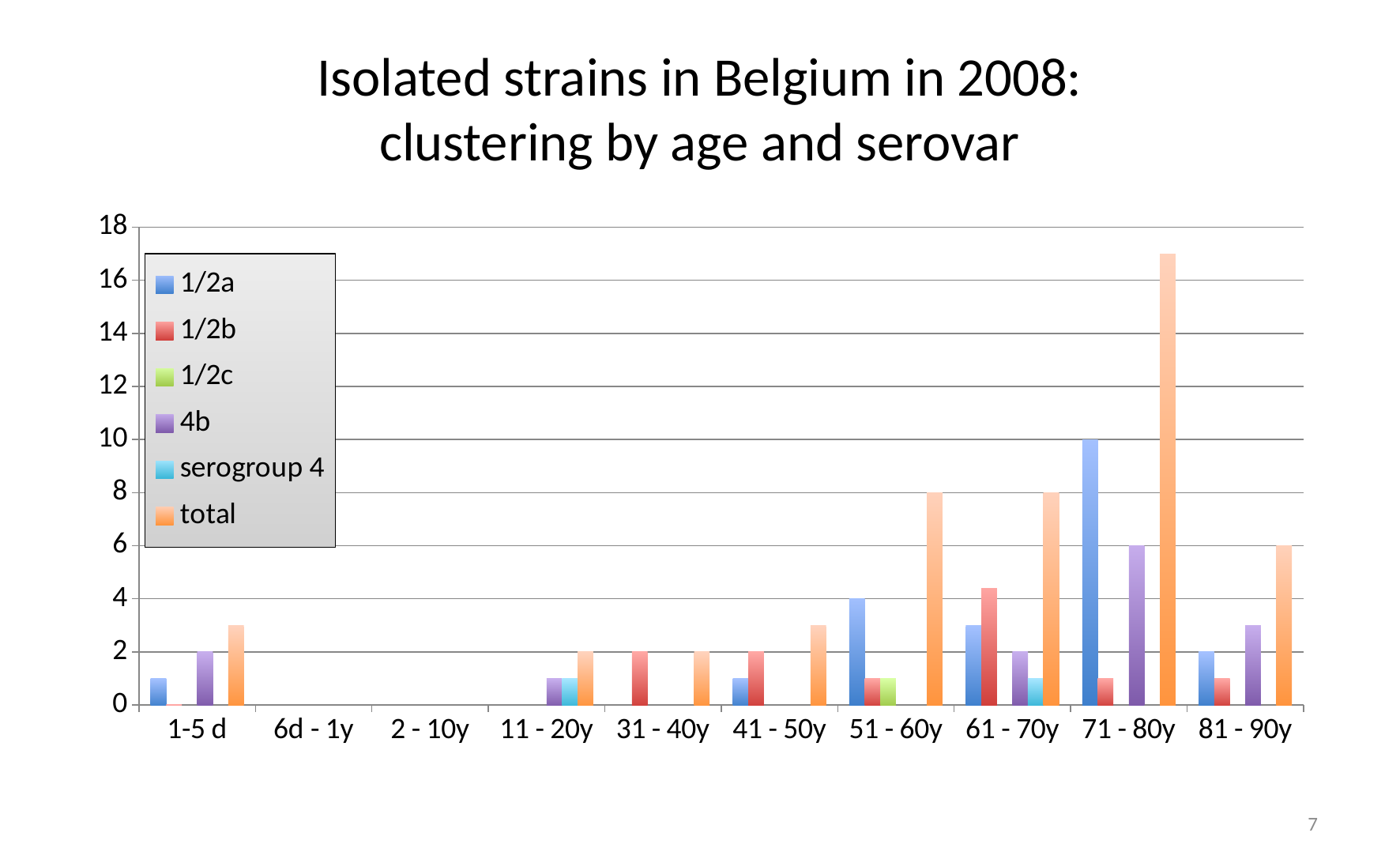
What is the value of the 1/2a bar for the 71 - 80y age group? 10 Is the total for the 71 - 80y age group greater or less than 16? greater What is the title of the chart? Isolated strains in Belgium in 2008: clustering by age and serovar In the 71 - 80y age group, which is larger, the 1/2a bar or the 4b bar? 1/2a What is the difference between the 1/2a bar and the 4b bar in the 71 - 80y age group? 4 How many series does the legend list? 6 What is the value of the 1/2a bar for the 51 - 60y age group? 4 What is the value of the 4b bar for the 71 - 80y age group? 6 What is the value of the total bar for the 51 - 60y age group? 8 What type of chart is shown on the slide? bar chart How many age-group categories are shown on the x axis? 10 Which age group has the highest total bar? 71 - 80y